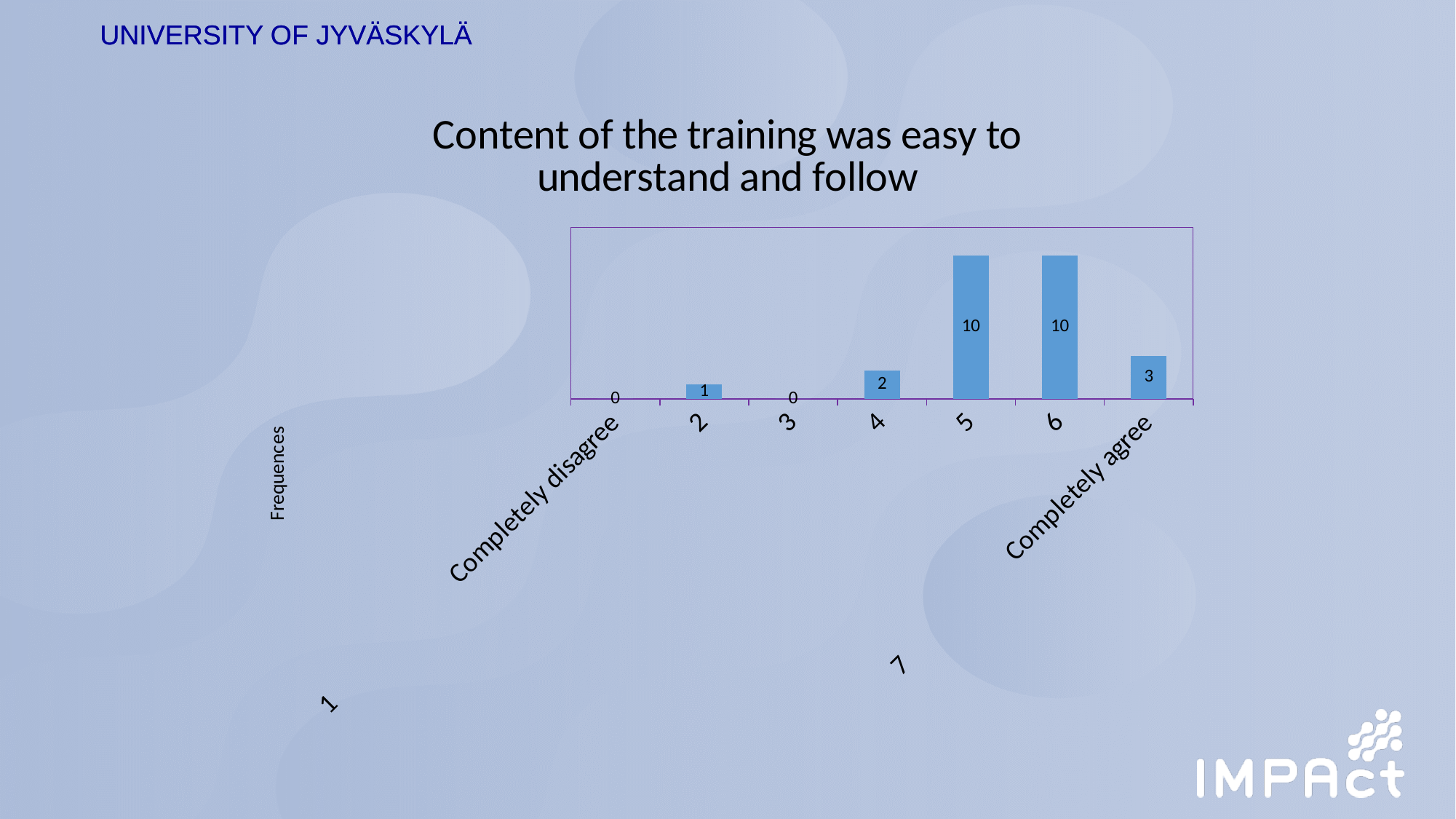
What is the label on the vertical axis of the chart? Frequences What is the title of the chart? Content of the training was easy to understand and follow How many categories are shown on the x axis of the chart? 7 What is the value for the category "5"? 10 Which has a larger value, "4" or "Completely agree"? Completely agree What is the value for the category "4"? 2 What is the difference between the values for "6" and "Completely agree"? 7 What is the value for the category "2"? 1 What is the value for the category "Completely agree"? 3 What is the value for the category "3"? 0 What type of chart is shown on the slide? bar chart What is the value for the category "Completely disagree"? 0